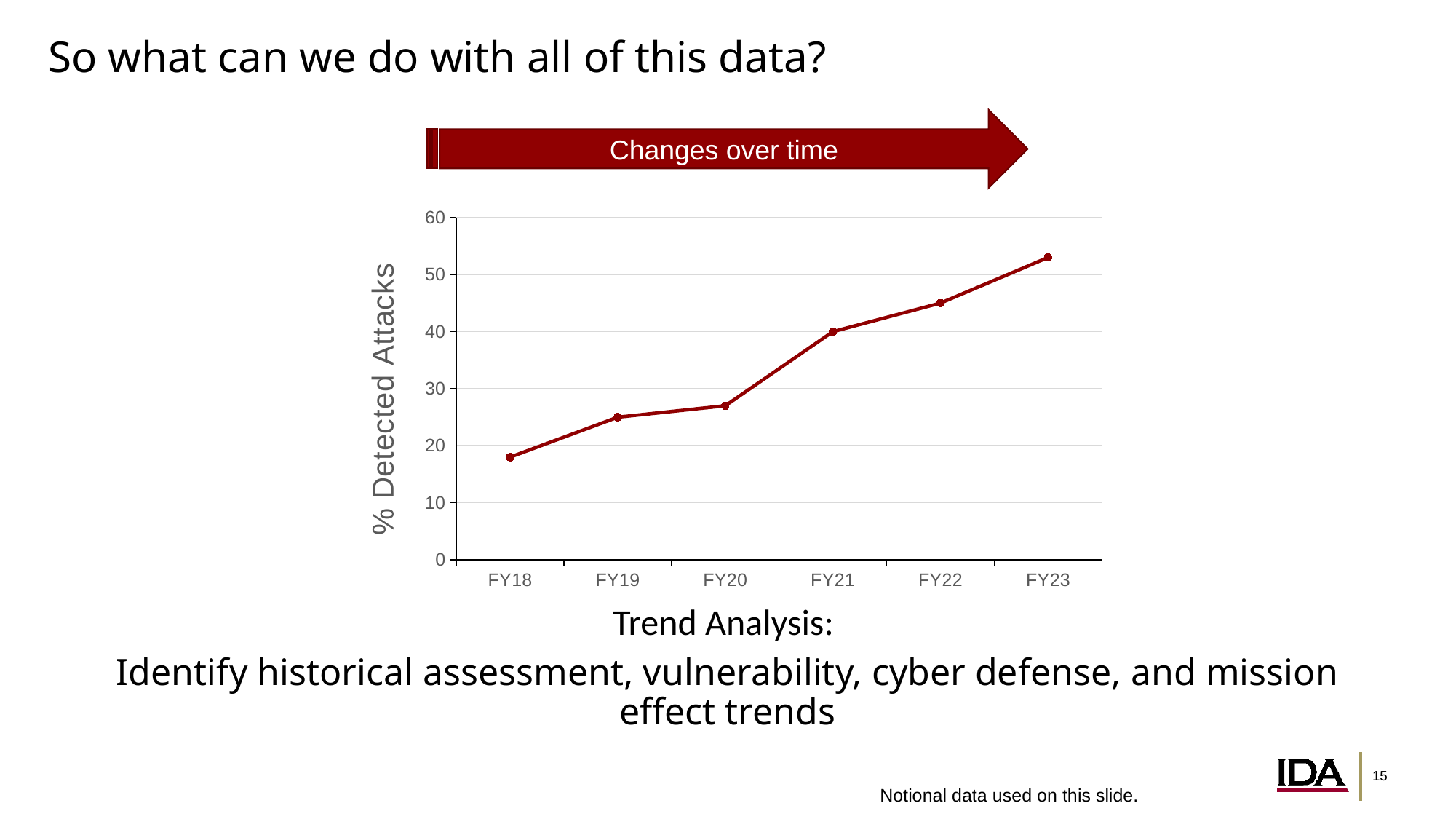
What text appears in the arrow above the chart? Changes over time What kind of chart is shown on the slide? line chart Do the % Detected Attacks values rise or fall from FY18 to FY23? rise Which fiscal year has the highest % Detected Attacks? FY23 Is the value for FY20 greater or less than 30? less Is the value for FY22 greater or less than 40? greater Is the value for FY23 greater or less than 50? greater Which has a higher % Detected Attacks, FY19 or FY21? FY21 What is the label on the y axis of the chart? % Detected Attacks Which fiscal year has the lowest % Detected Attacks? FY18 How many fiscal years are plotted on the x axis of the chart? 6